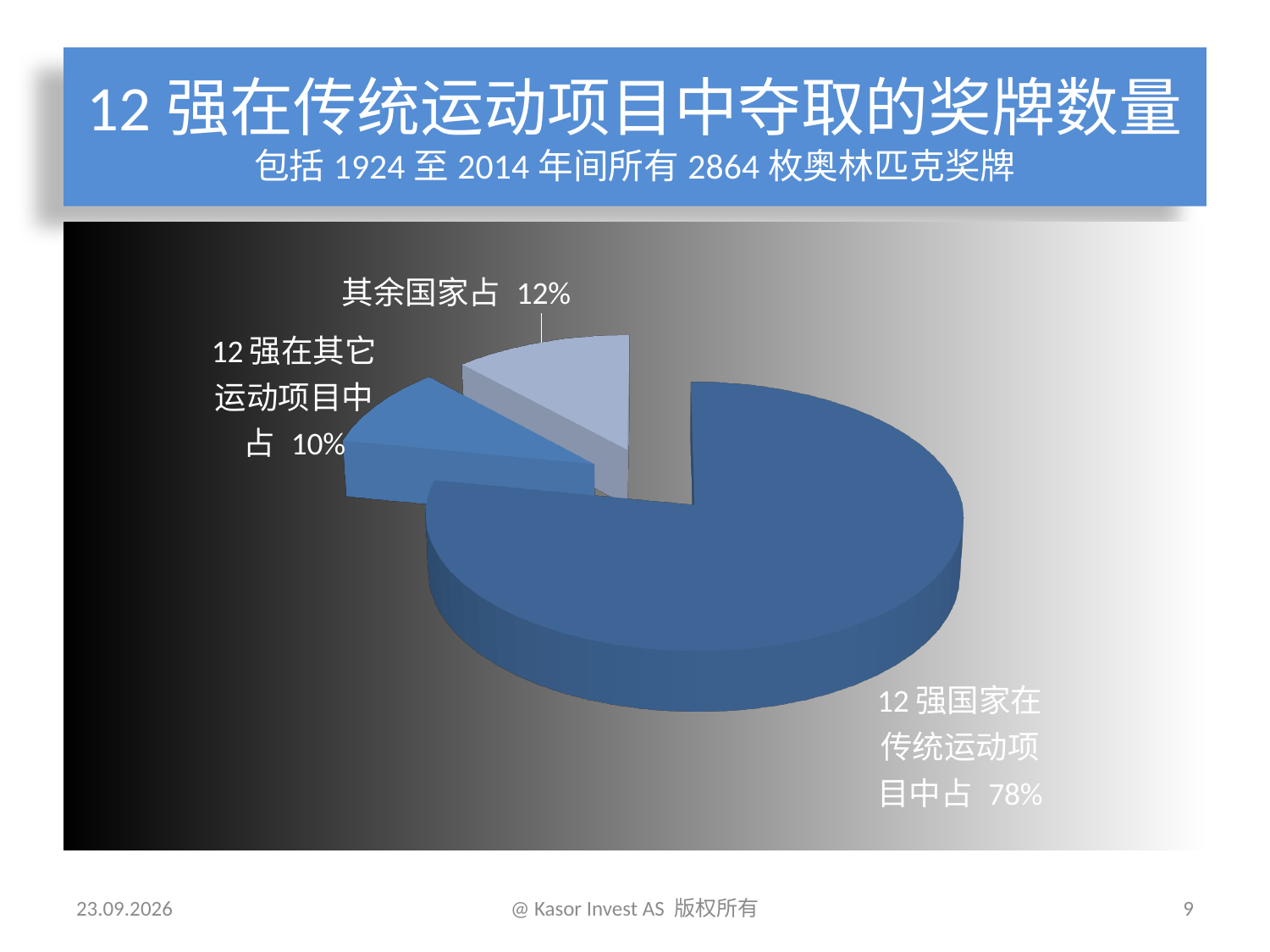
What is the difference in percentage points between the 其余国家占 slice and the 12 强在其它运动项目中占 slice? 2 What share of the pie is labelled 12 强在其它运动项目中占? 10% What share of the pie is labelled 其余国家占? 12% What is the title of the chart on the slide? 12 强在传统运动项目中夺取的奖牌数量 Which slice of the pie chart is the largest? 12 强国家在传统运动项目中占 Which is larger: the share for 其余国家占 or the share for 12 强在其它运动项目中占? 其余国家占 What kind of chart is shown on the slide? pie chart What is the difference in percentage points between the 12 强国家在传统运动项目中占 slice and the 其余国家占 slice? 66 How many slices does the pie chart have? 3 What share of the pie is labelled 12 强国家在传统运动项目中占? 78% Which slice of the pie chart is the smallest? 12 强在其它运动项目中占 According to the subtitle, how many Olympic medals does the chart cover? 2864